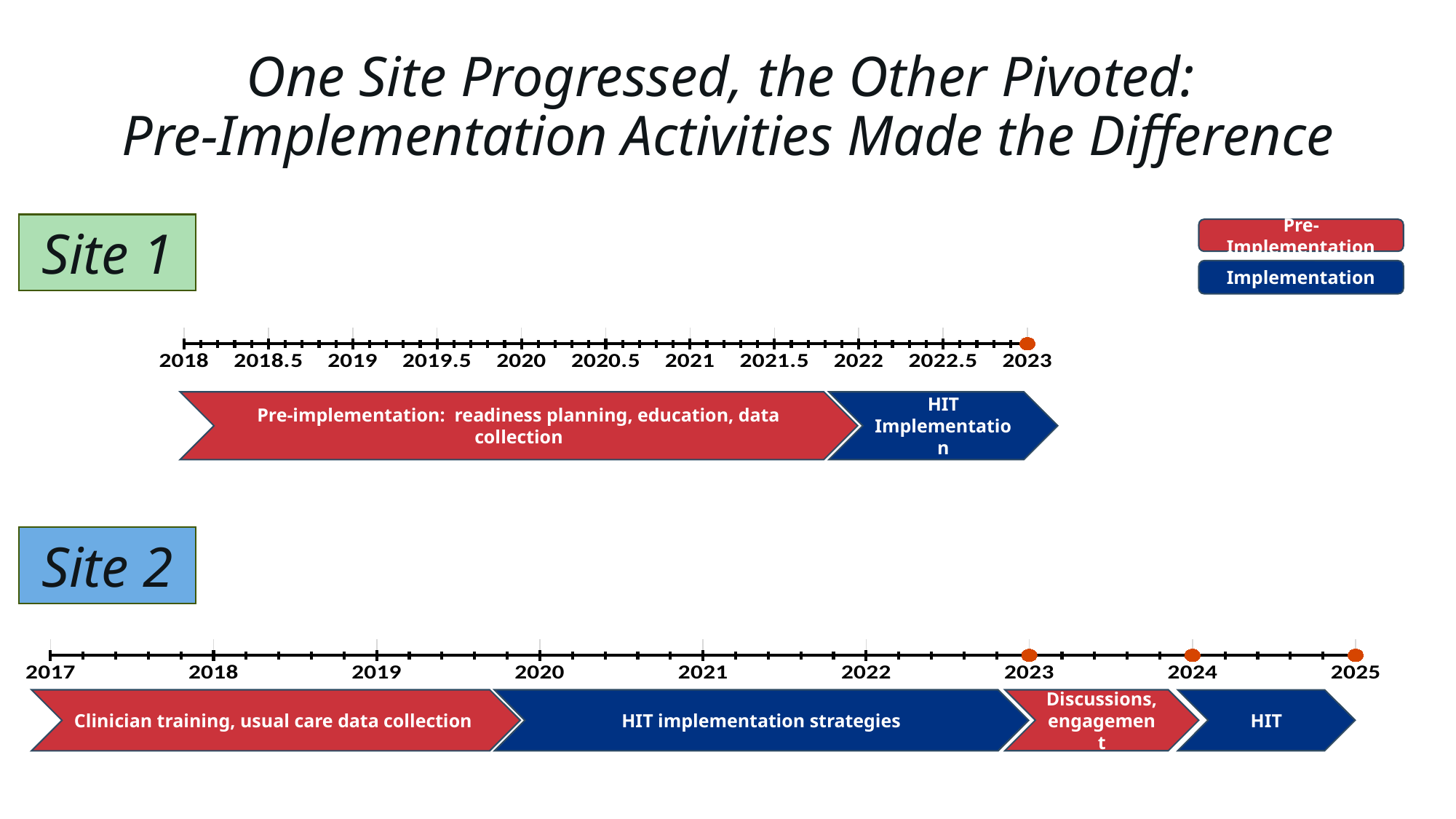
On the Site 2 timeline, what is the first year shown on the axis? 2017 What kind of chart is shown for each site? Timeline According to the legend, which colour represents Pre-Implementation? Red On the Site 1 timeline, what is the last year shown on the axis? 2023 On the Site 2 timeline, which phase comes immediately after 'HIT implementation strategies'? Discussions, engagement On the Site 1 timeline, how many phases (arrow segments) are shown? 2 On the Site 2 timeline, what is the last year shown on the axis? 2025 On the Site 1 timeline, which phase spans a longer period, the pre-implementation phase or the HIT Implementation phase? Pre-implementation How many entries does the legend list? 2 On the Site 1 timeline, what is the first year shown on the axis? 2018 On the Site 2 timeline, how many orange marker dots are shown on the axis? 3 On the Site 2 timeline, how many phases (arrow segments) are shown? 4